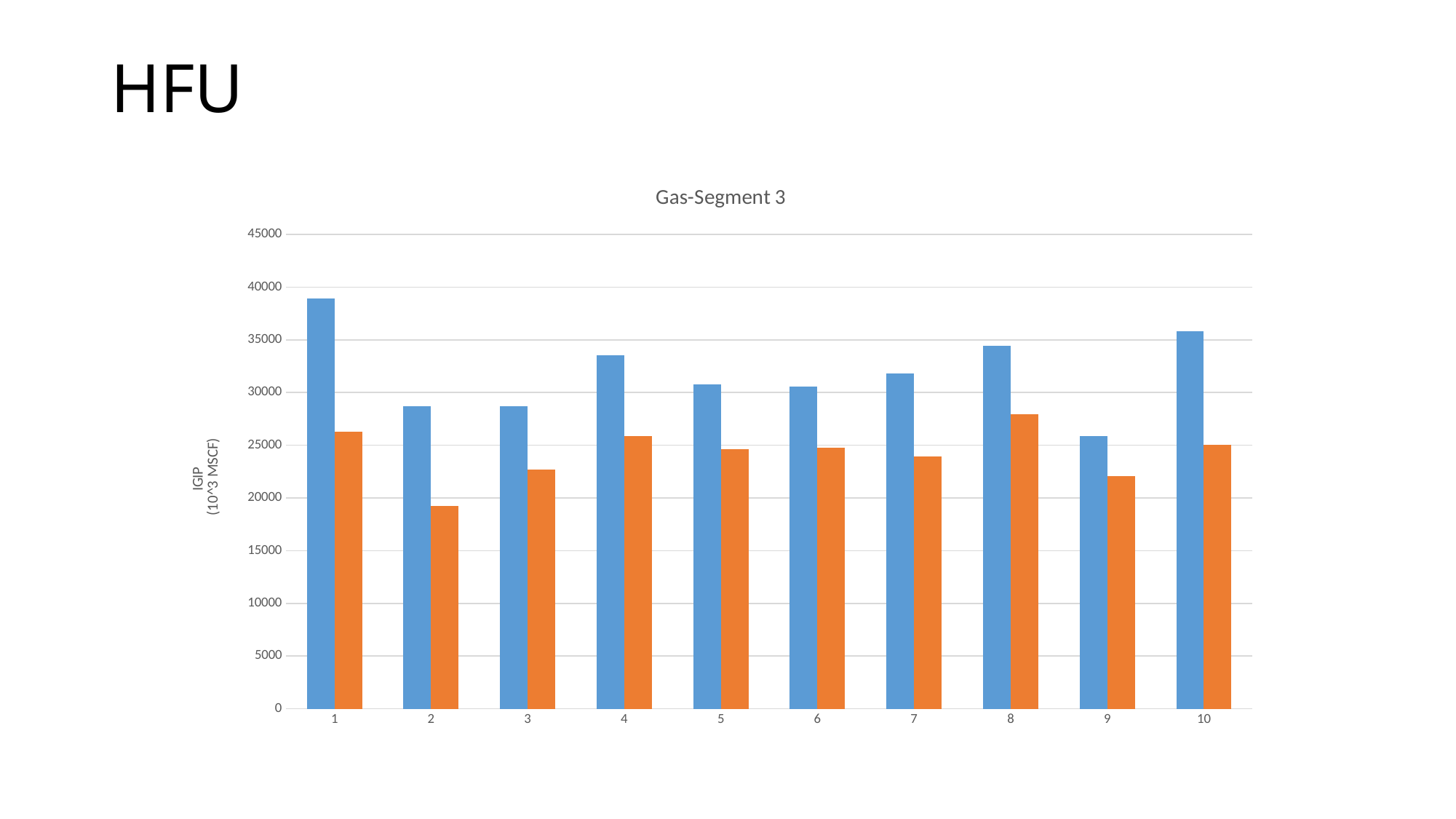
Which category has the lowest blue bar? 9 How many series of bars are plotted for each category? 2 Which category has the highest blue bar? 1 What type of chart is shown on the slide? bar chart Which category has the lowest orange bar? 2 Which category has the highest orange bar? 8 Is the blue bar for category 1 greater or less than 35000? greater Is the orange bar for category 2 greater or less than 20000? less What is the title of the chart? Gas-Segment 3 What is the label on the vertical axis of the chart? IGIP (10^3 MSCF) How many categories are shown along the x axis? 10 In category 4, which bar is larger, the blue one or the orange one? blue